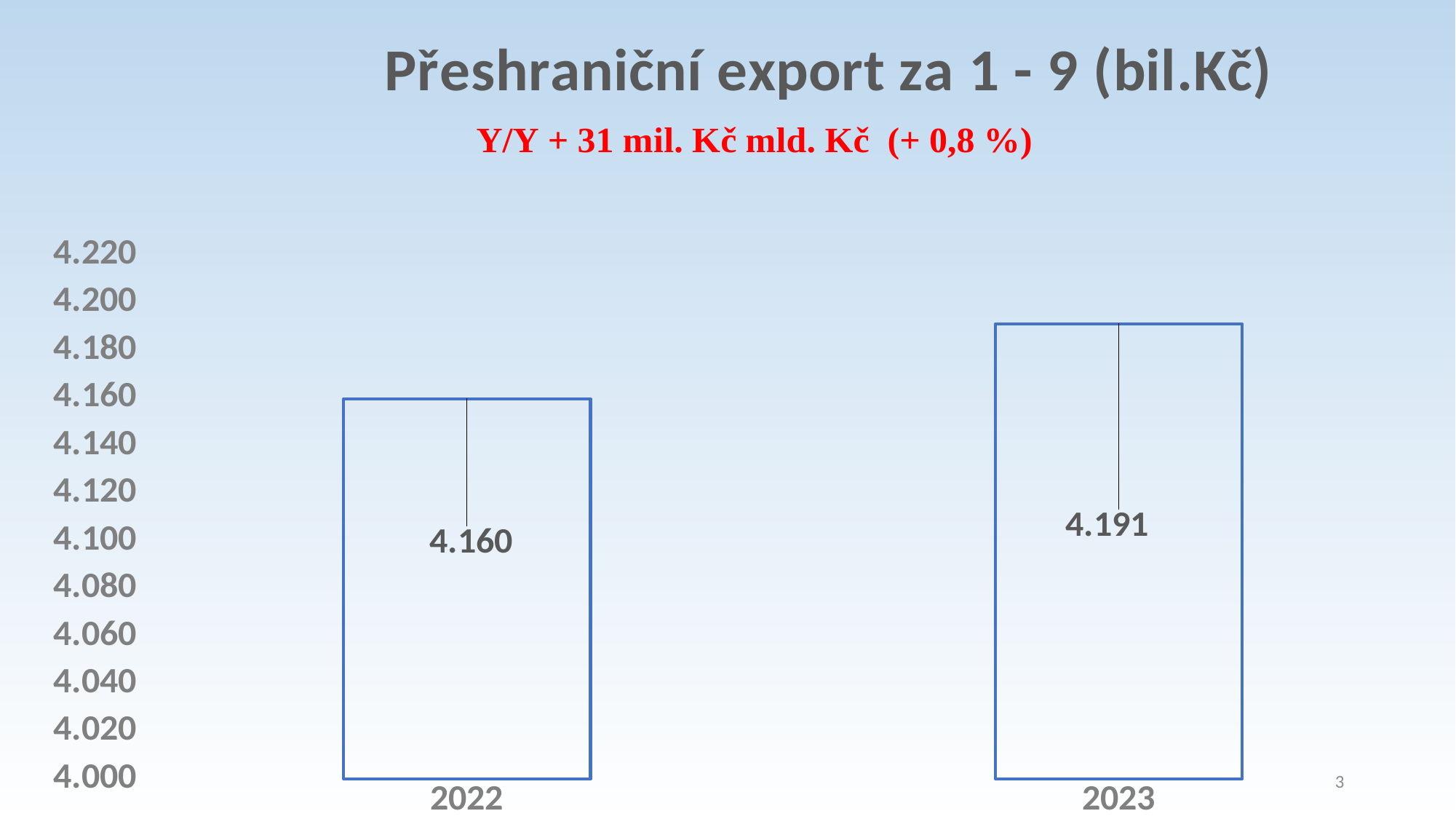
What kind of chart is shown on the slide? bar chart What is the title of the chart? Přeshraniční export za 1 - 9 (bil.Kč) How many bars are shown in the chart? 2 What is the difference between the values for 2023 and 2022? 0.031 Is the value for 2022 larger or smaller than the value for 2023? smaller Is the value for 2022 greater or less than 4.200? less What is the value for 2023? 4.191 Do the values rise or fall from 2022 to 2023? rise Which year has the lower value? 2022 Is the value for 2023 greater or less than 4.180? greater Which year has the higher value? 2023 What is the value for 2022? 4.160